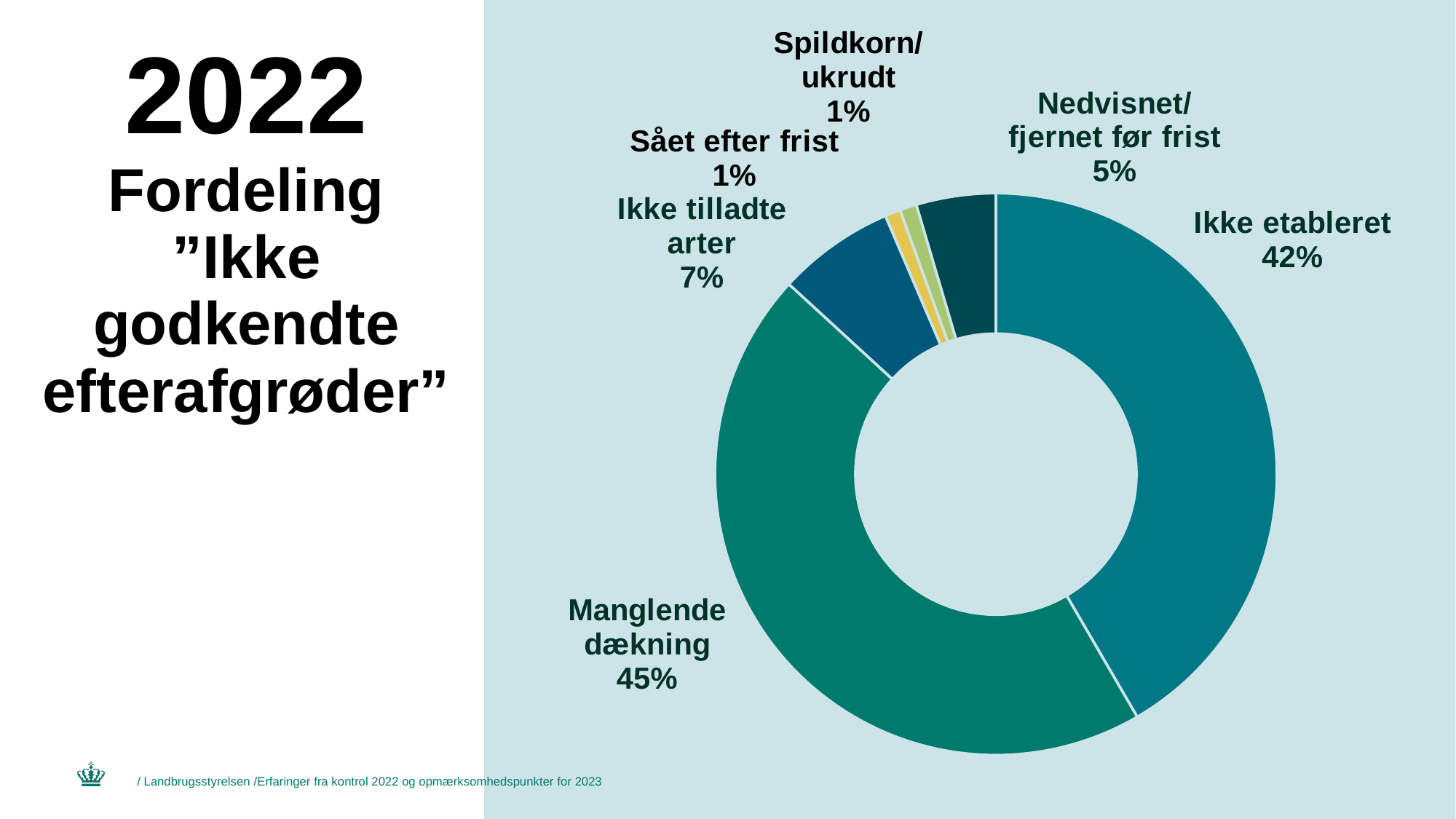
What is the difference in percentage points between "Manglende dækning" and "Ikke etableret"? 3 percentage points How many categories are shown in the pie chart? 6 What share of the pie does "Manglende dækning" account for? 45% Which is larger: the share for "Ikke tilladte arter" or for "Nedvisnet/fjernet før frist"? Ikke tilladte arter What kind of chart is shown on the slide? Pie chart (donut) What is the value shown for "Nedvisnet/fjernet før frist"? 5% What is the value shown for "Spildkorn/ukrudt"? 1% What is the value shown for "Ikke etableret"? 42% What is the combined share of "Ikke etableret" and "Manglende dækning"? 87% What is the value shown for "Ikke tilladte arter"? 7% Which category has the largest share of the pie? Manglende dækning Which year does the chart's title refer to? 2022